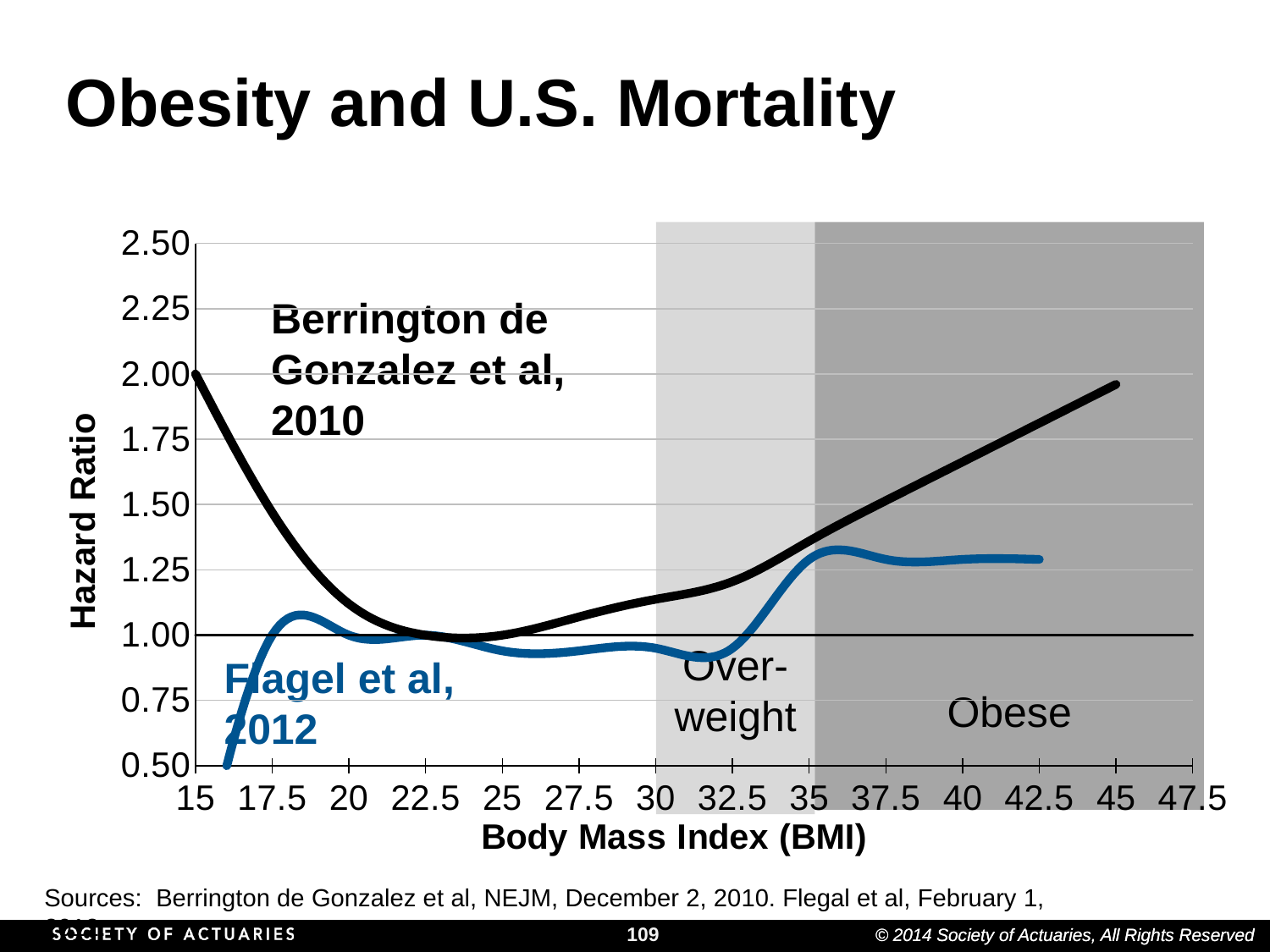
Is the hazard ratio for the Berrington de Gonzalez et al, 2010 line at BMI 45 greater or less than 1.75? greater Does the Berrington de Gonzalez et al, 2010 line rise or fall as BMI increases from 35 to 45? rise What kind of chart is shown on the slide? line chart Is the hazard ratio for the Flegal et al, 2012 line at BMI 32.5 greater or less than 1.00? less What is the title of the chart's x axis? Body Mass Index (BMI) Does the Berrington de Gonzalez et al, 2010 line rise or fall as BMI increases from 15 to 22.5? fall What is the title of the chart's y axis? Hazard Ratio At BMI 40, which series has the higher hazard ratio, Berrington de Gonzalez et al, 2010 or Flegal et al, 2012? Berrington de Gonzalez et al, 2010 How many data series are plotted on the chart? 3 Is the hazard ratio for the Flegal et al, 2012 line at BMI 42.5 greater or less than 1.00? greater Which series reaches the highest hazard ratio on the chart? Berrington de Gonzalez et al, 2010 At which BMI value does the Berrington de Gonzalez et al, 2010 line reach its highest hazard ratio? 15